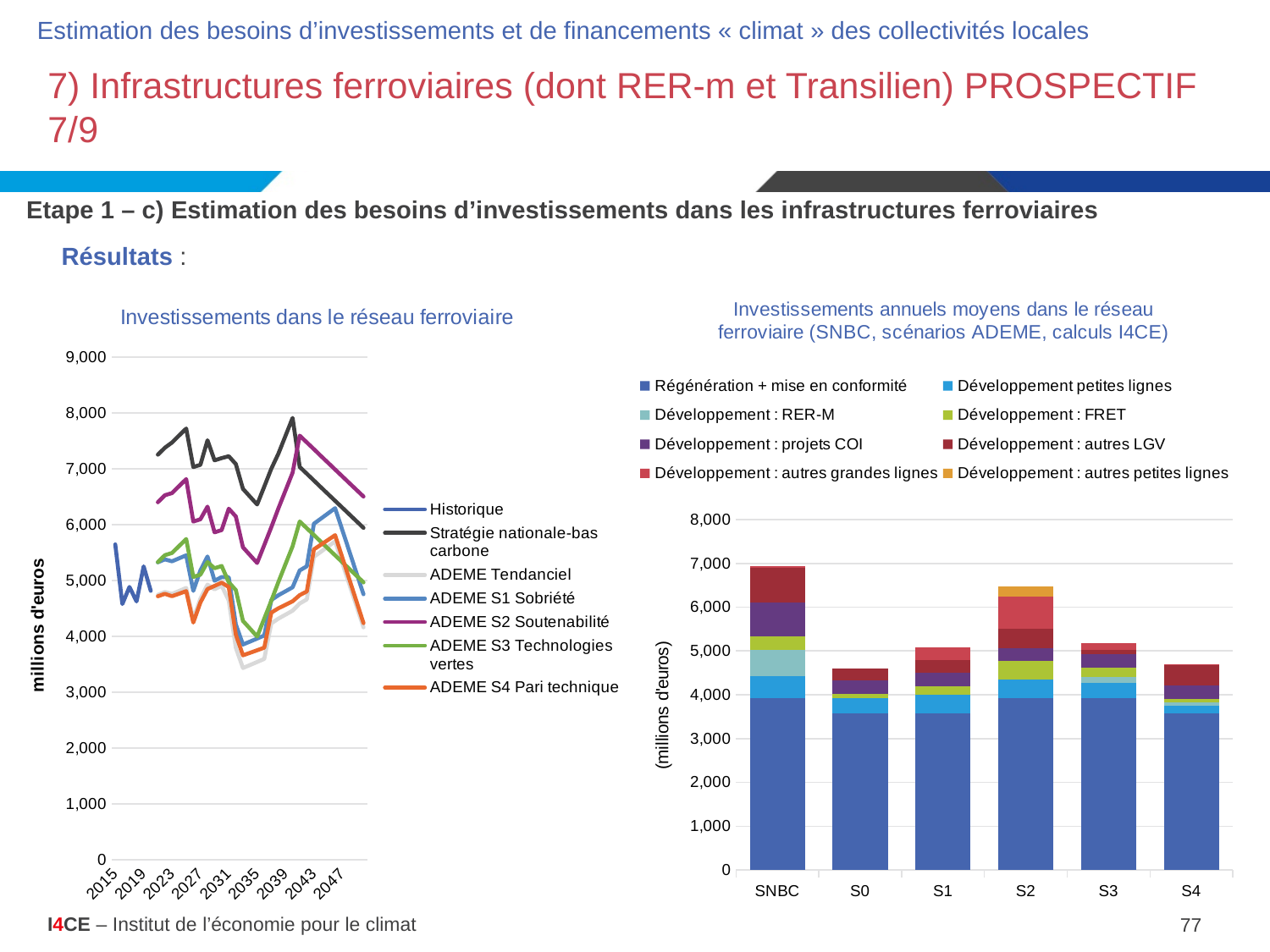
In the right chart 'Investissements annuels moyens dans le réseau ferroviaire', is the total for S0 greater or less than 5,000? less In the left chart 'Investissements dans le réseau ferroviaire', is the lowest value of the 'ADEME Tendanciel' series greater or less than 4,000? less In the left chart 'Investissements dans le réseau ferroviaire', is the peak value of the 'Stratégie nationale-bas carbone' series greater or less than 7,000? greater What kind of chart is the right chart 'Investissements annuels moyens dans le réseau ferroviaire'? stacked bar chart How many categories are shown on the x axis of the right chart 'Investissements annuels moyens dans le réseau ferroviaire'? 6 In the right chart 'Investissements annuels moyens dans le réseau ferroviaire', which category has the highest total bar? SNBC In the right chart 'Investissements annuels moyens dans le réseau ferroviaire', which has the larger total bar, S2 or S3? S2 How many series does the legend of the right chart 'Investissements annuels moyens dans le réseau ferroviaire' list? 8 What is the y-axis label of the left chart 'Investissements dans le réseau ferroviaire'? millions d'euros How many series does the legend of the left chart 'Investissements dans le réseau ferroviaire' list? 7 What kind of chart is the left chart titled 'Investissements dans le réseau ferroviaire'? line chart